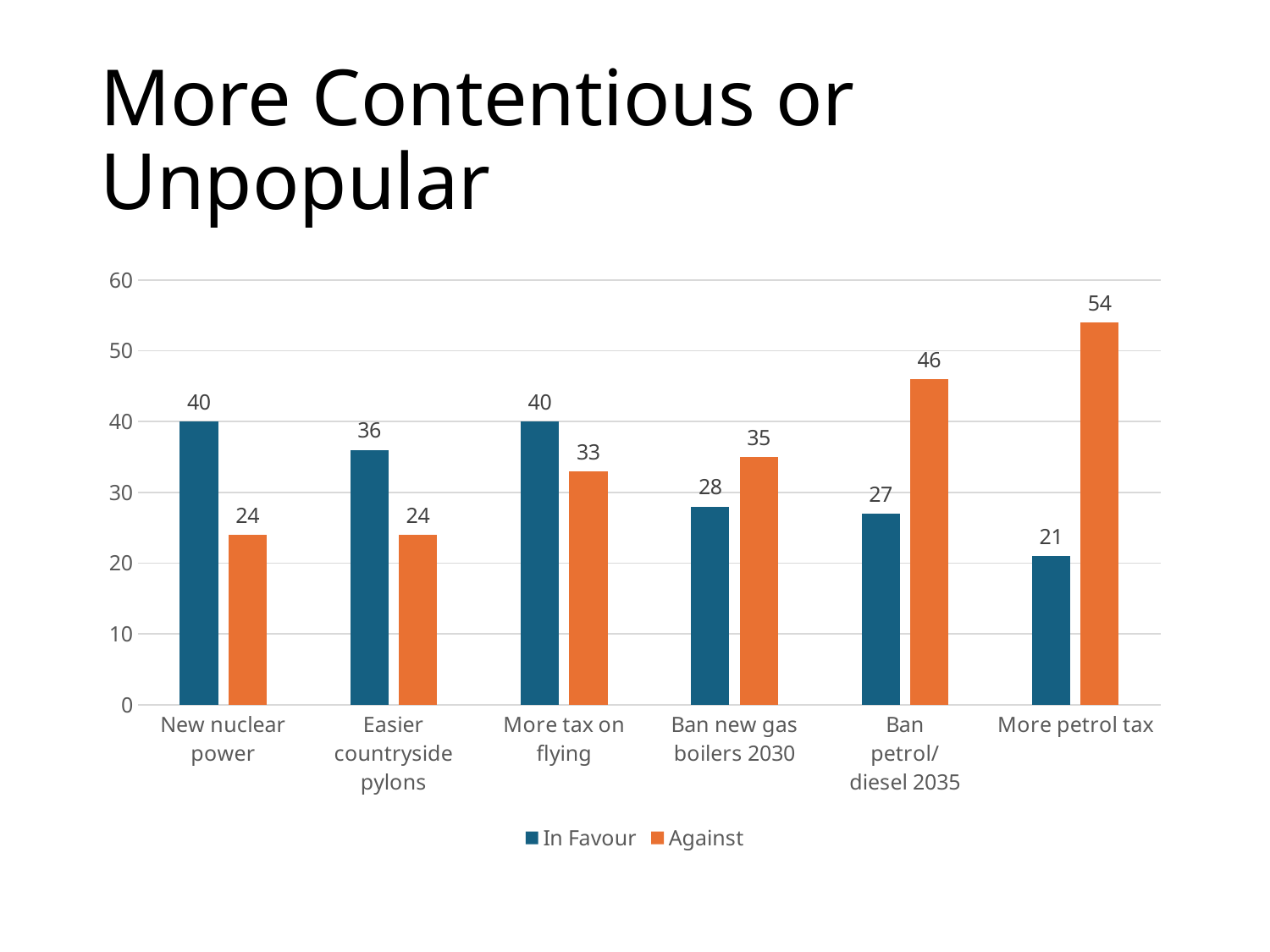
Which is larger for Easier countryside pylons, In Favour or Against? In Favour What is the difference between the Against and In Favour values for Ban petrol/diesel 2035? 19 Which category has the highest Against value? More petrol tax How many series does the legend list? 2 What kind of chart is shown on the slide? Bar chart Is the Against value for More petrol tax greater or less than 50? greater How many categories are shown on the x axis? 6 What is the In Favour value for New nuclear power? 40 Which category has the lowest In Favour value? More petrol tax What is the title of the slide? More Contentious or Unpopular What is the Against value for More petrol tax? 54 What is the Against value for Ban new gas boilers 2030? 35